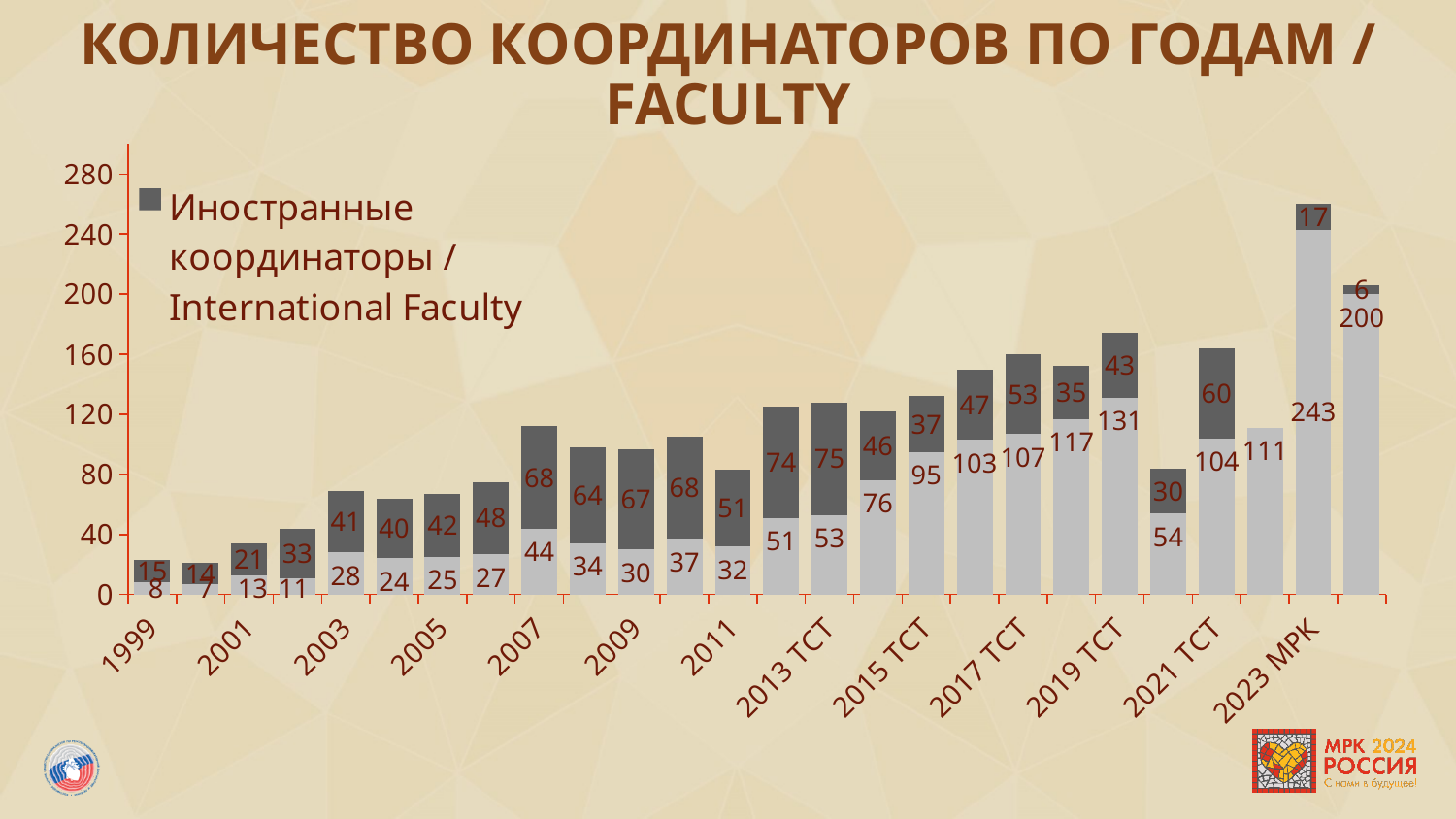
What type of chart is shown on the slide? Stacked bar chart What is the value of the International Faculty (dark grey) segment for 2023 МРК? 17 Which labelled year has the tallest bar overall? 2023 МРК What is the value of the International Faculty (dark grey) segment for 2019 ТСТ? 43 Which labelled year has the highest International Faculty (dark grey) value? 2013 ТСТ What is the difference between the lower (light grey) segments for 2023 МРК (243) and 2021 ТСТ (104)? 139 What is the value of the lower (light grey) segment for 2023 МРК? 243 How many bars are plotted in the chart? 26 How many series does the legend list? 1 Which has the larger International Faculty value, 2017 ТСТ or 2015 ТСТ? 2017 ТСТ Is the total height of the 2019 ТСТ bar greater or less than 160? greater What is the total height of the 2023 МРК bar (243 + 17)? 260